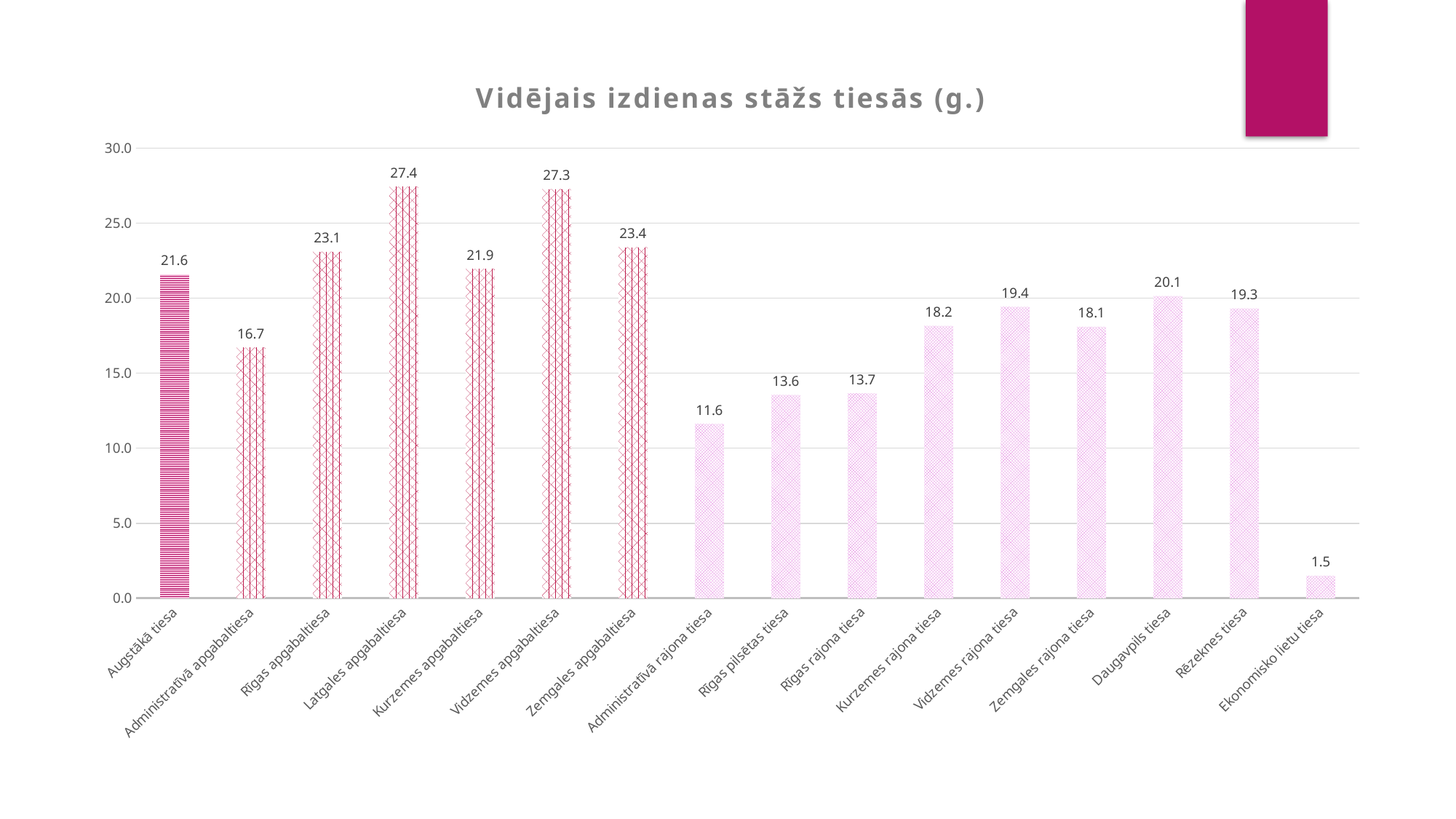
Is the value for Rēzeknes tiesa greater or less than 20.0? less What is the value for Administratīvā rajona tiesa? 11.6 What is the value for Augstākā tiesa? 21.6 What kind of chart is shown on the slide? bar chart What is the value for Latgales apgabaltiesa? 27.4 Which is larger, the value for Rīgas apgabaltiesa or the value for Kurzemes apgabaltiesa? Rīgas apgabaltiesa How many categories are shown on the x axis? 16 Which category has the highest value? Latgales apgabaltiesa Which category has the lowest value? Ekonomisko lietu tiesa What is the title of the chart? Vidējais izdienas stāžs tiesās (g.) What is the value for Daugavpils tiesa? 20.1 What is the difference between the values for Zemgales apgabaltiesa and Administratīvā apgabaltiesa? 6.7